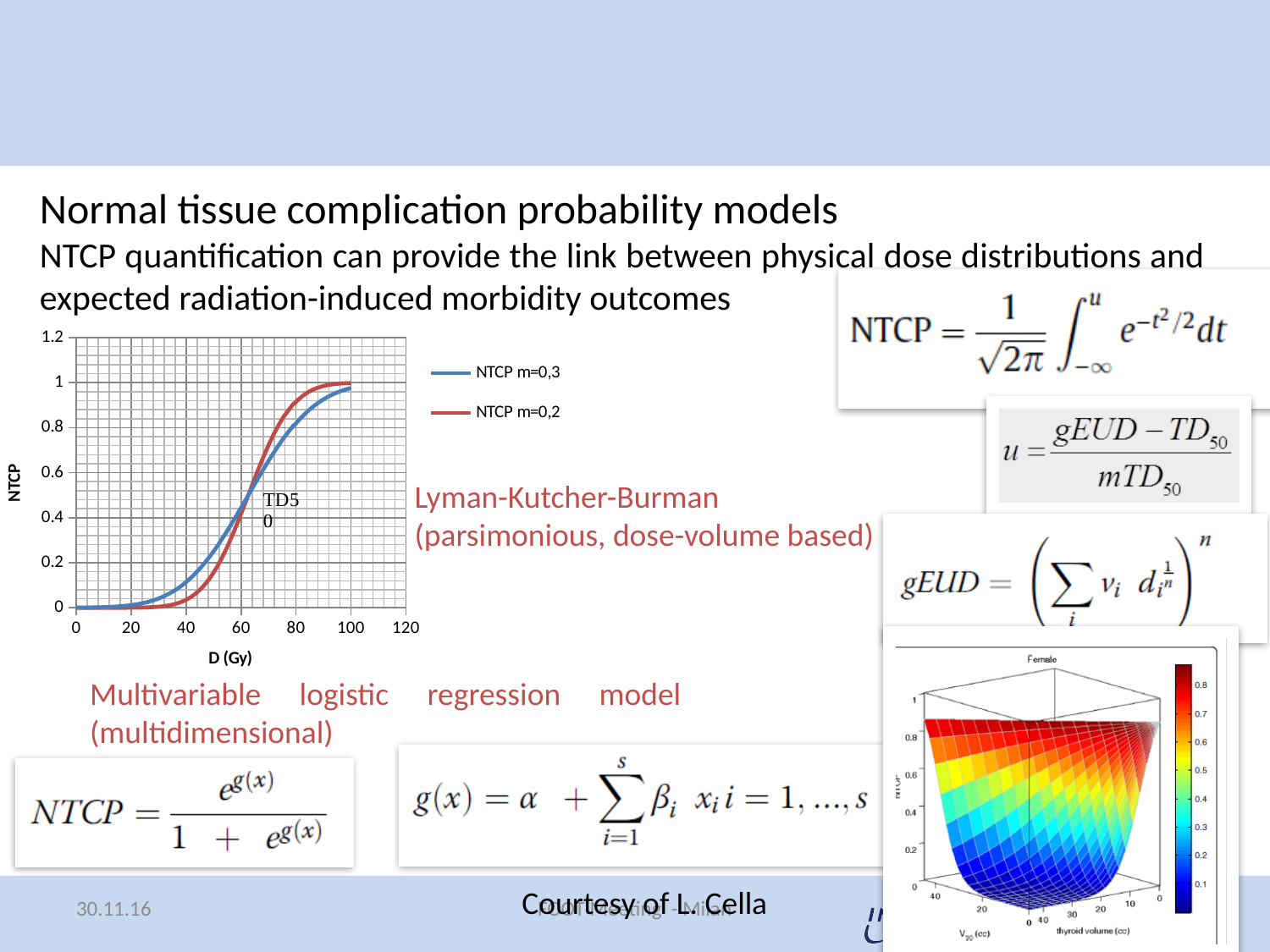
What is the x-axis title of the NTCP chart? D (Gy) In the NTCP chart, at D = 80 Gy, which series has the larger value, NTCP m=0,3 or NTCP m=0,2? NTCP m=0,2 In the NTCP chart, at D = 40 Gy, which series has the larger value, NTCP m=0,3 or NTCP m=0,2? NTCP m=0,3 What are the two series named in the legend of the NTCP chart? NTCP m=0,3 and NTCP m=0,2 What kind of chart is the NTCP versus D (Gy) chart on the left of the slide? line chart In the NTCP chart, do the values of the NTCP m=0,2 series rise or fall as D (Gy) increases? rise In the NTCP chart, is the value of the NTCP m=0,2 series at D = 100 Gy greater or less than 0.8? greater In the NTCP chart, is the value of the NTCP m=0,2 series at D = 80 Gy greater or less than 0.6? greater How many series does the legend of the NTCP chart list? 2 In the NTCP chart, is the value of the NTCP m=0,3 series at D = 40 Gy greater or less than 0.2? less In the NTCP chart, do the values of the NTCP m=0,3 series rise or fall as D (Gy) increases? rise